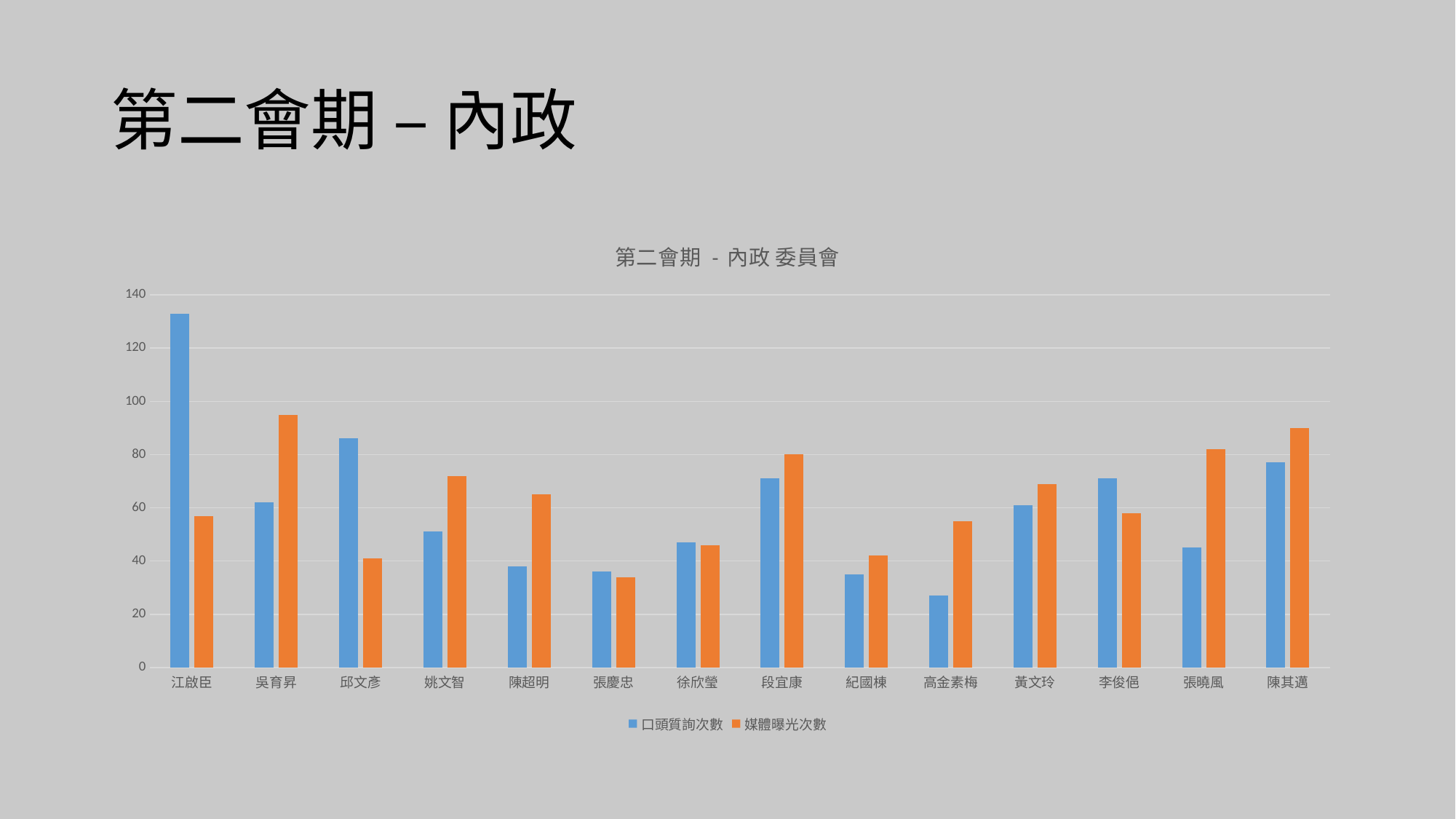
How many series does the legend list? 2 Which legislator has the lowest 口頭質詢次數? 高金素梅 Which legislator has the highest 口頭質詢次數? 江啟臣 How many legislators (categories) are shown on the x axis? 14 What kind of chart is shown on the slide? bar chart Is the 媒體曝光次數 value for 段宜康 greater or less than 60? greater Is the 口頭質詢次數 value for 江啟臣 greater or less than 120? greater Which legislator has the lowest 媒體曝光次數? 張慶忠 What is the title of the chart? 第二會期 - 內政 委員會 Is the 口頭質詢次數 value for 高金素梅 greater or less than 40? less For 吳育昇, which is larger: 口頭質詢次數 or 媒體曝光次數? 媒體曝光次數